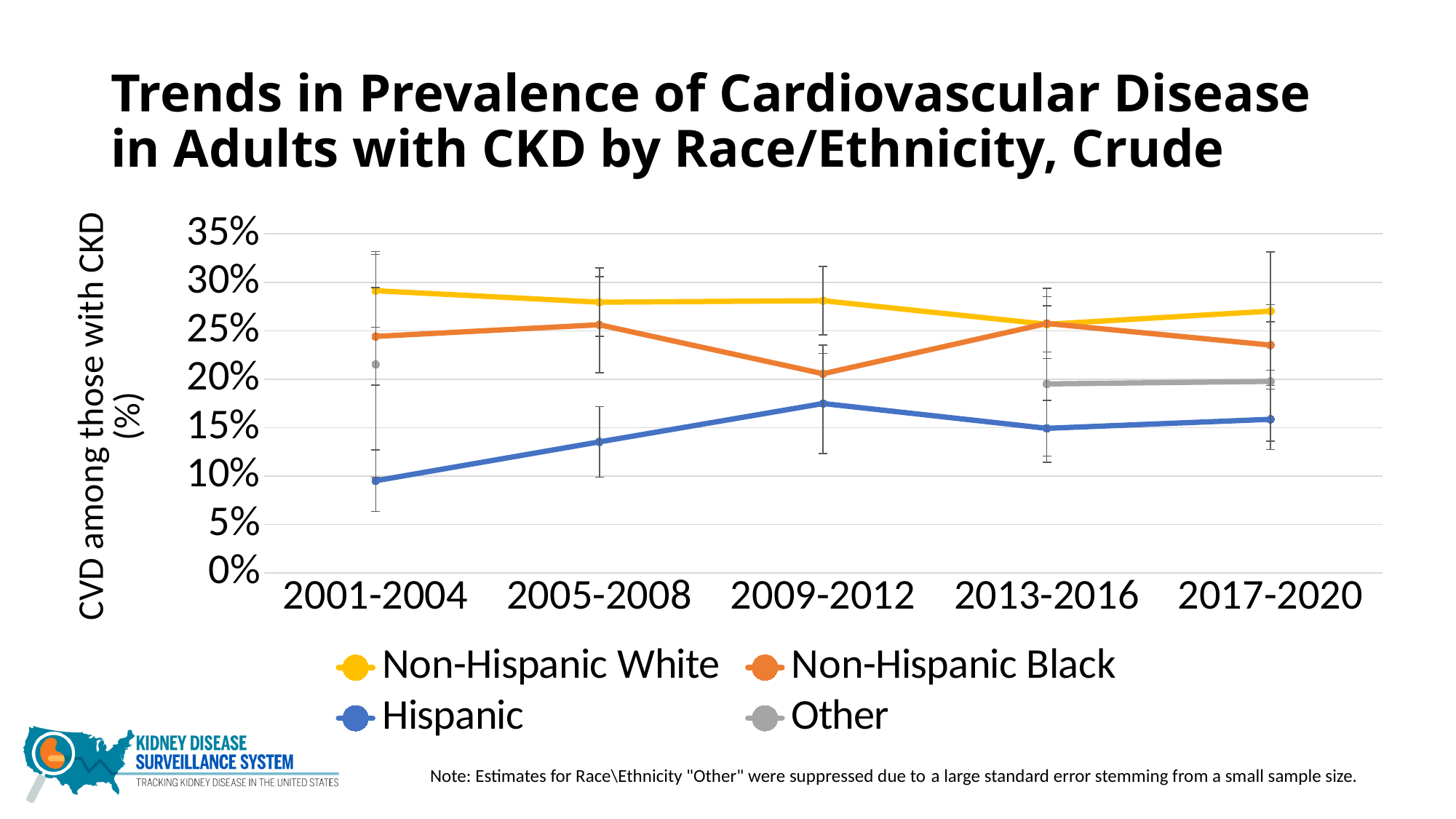
In which time period does the Hispanic series reach its highest value? 2009-2012 Is the value for Non-Hispanic Black in 2009-2012 greater or less than 25%? less Which race/ethnicity group has the lowest CVD prevalence in 2001-2004? Hispanic How many time periods are shown on the x axis? 5 How many series does the legend list? 4 What kind of chart is shown on the slide? line chart Is the value for Hispanic in 2001-2004 greater or less than 15%? less Which series has no plotted values for 2005-2008 and 2009-2012? Other Does the Hispanic line rise or fall from 2001-2004 to 2009-2012? rise Is the value for Non-Hispanic White in 2001-2004 greater or less than 25%? greater In 2009-2012, which is larger: the value for Non-Hispanic Black or the value for Hispanic? Non-Hispanic Black Which race/ethnicity group has the highest CVD prevalence in 2001-2004? Non-Hispanic White